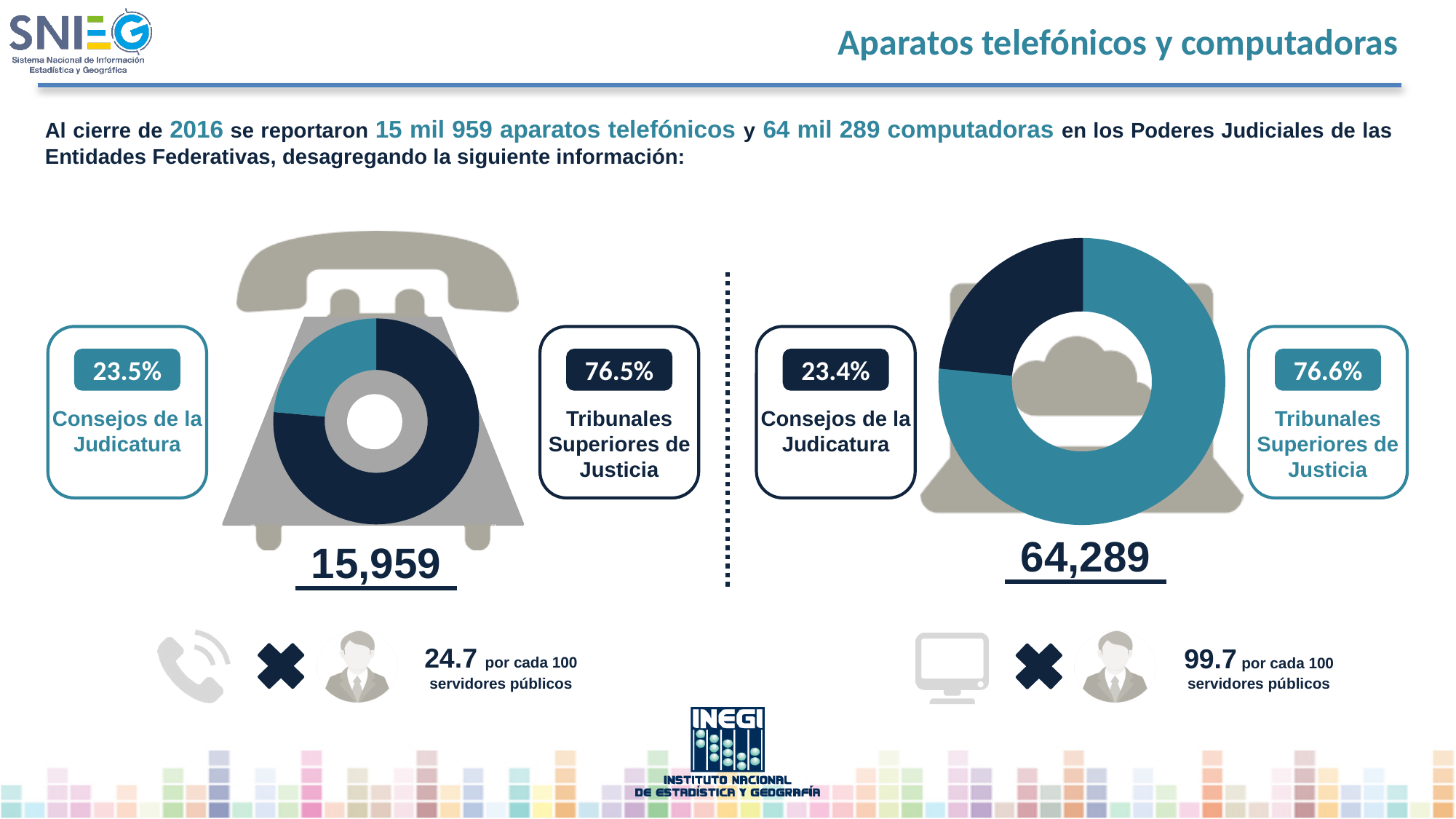
In the right donut chart (computadoras), what share corresponds to Consejos de la Judicatura? 23.4% How many aparatos telefónicos per 100 servidores públicos are reported at the bottom left of the slide? 24.7 In the right donut chart (computadoras), what share corresponds to Tribunales Superiores de Justicia? 76.6% How many categories does each donut chart on the slide show? 2 What total number of computadoras is shown under the right donut chart? 64,289 In the left donut chart (aparatos telefónicos), what share corresponds to Tribunales Superiores de Justicia? 76.5% In the left donut chart (aparatos telefónicos), which category has the largest share? Tribunales Superiores de Justicia In the right donut chart (computadoras), which category has the smallest share? Consejos de la Judicatura What kind of chart is used on the left side of the slide to show the split of aparatos telefónicos? Donut (pie) chart In the left donut chart (aparatos telefónicos), what is the difference in percentage points between Tribunales Superiores de Justicia and Consejos de la Judicatura? 53 percentage points What total number of aparatos telefónicos is shown under the left donut chart? 15,959